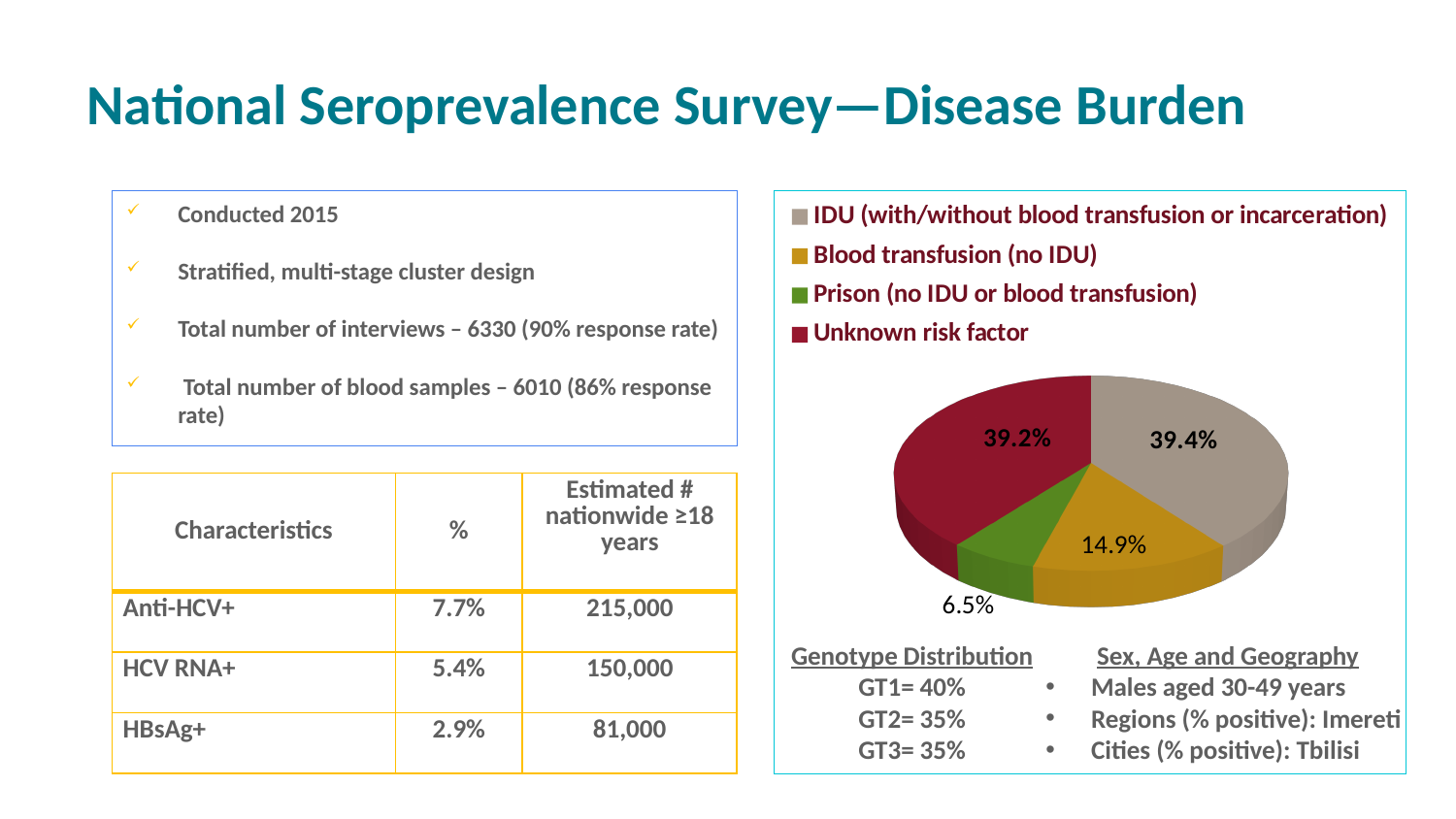
In the pie chart, what percentage is shown for IDU (with/without blood transfusion or incarceration)? 39.4% In the pie chart, what is the difference between the IDU slice and the Blood transfusion (no IDU) slice? 24.5% In the pie chart, what percentage is shown for Blood transfusion (no IDU)? 14.9% What colour represents Unknown risk factor in the pie chart? Dark red In the pie chart, what percentage is shown for Prison (no IDU or blood transfusion)? 6.5% What type of chart is shown on the right side of the slide? Pie chart How many slices does the pie chart have? 4 In the pie chart, which is larger: the Blood transfusion (no IDU) slice or the Prison (no IDU or blood transfusion) slice? Blood transfusion (no IDU) In the pie chart, what is the difference between the Blood transfusion (no IDU) slice and the Prison (no IDU or blood transfusion) slice? 8.4% In the pie chart, what percentage is shown for Unknown risk factor? 39.2% Which risk factor category has the smallest slice in the pie chart? Prison (no IDU or blood transfusion) How many entries does the legend of the pie chart list? 4